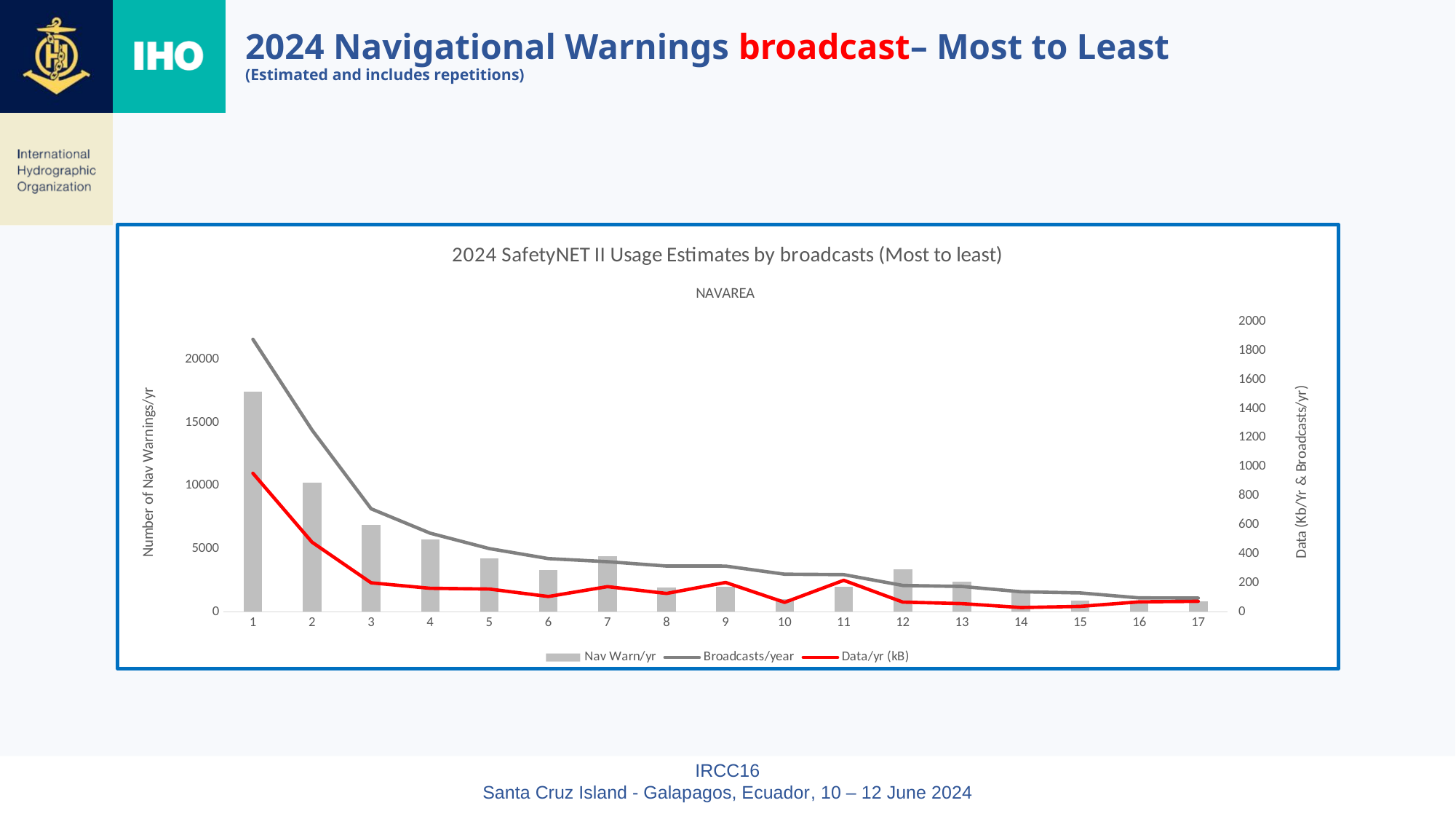
What is the title of the chart? 2024 SafetyNET II Usage Estimates by broadcasts (Most to least) Is the Broadcasts/year value for NAVAREA 1 greater or less than 1600? greater Which series is drawn as a red line? Data/yr (kB) Which NAVAREA has the highest Nav Warn/yr bar? 1 What kind of chart is this? Combined bar and line chart How many NAVAREA categories are shown on the x axis? 17 Does the Broadcasts/year line generally rise or fall from NAVAREA 1 to NAVAREA 17? fall Is the Nav Warn/yr value for NAVAREA 1 greater or less than 15000? greater Is the Nav Warn/yr value for NAVAREA 6 greater or less than 5000? less How many series does the chart legend list? 3 Which has the larger Nav Warn/yr value, NAVAREA 2 or NAVAREA 3? NAVAREA 2